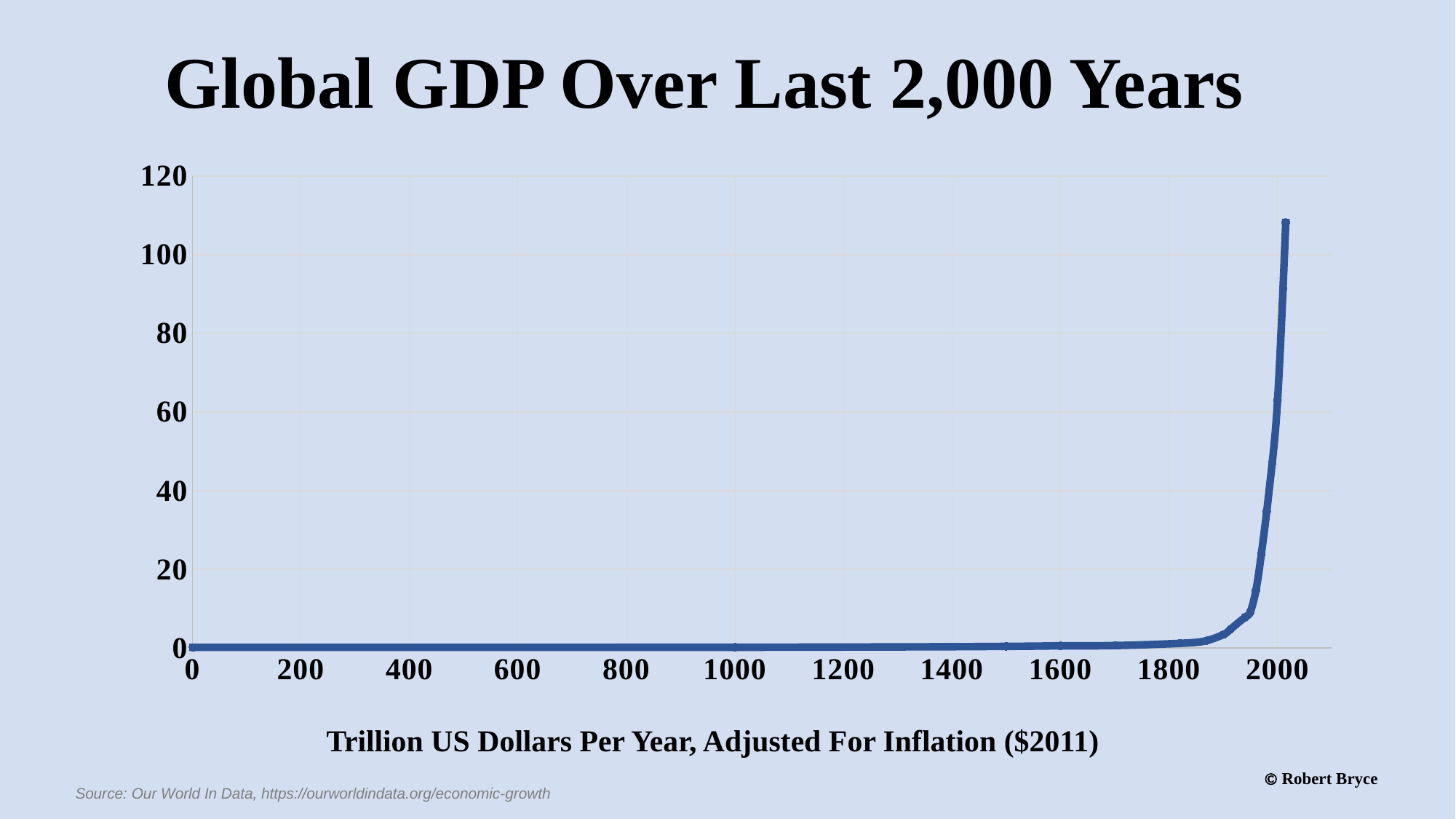
Is the value of global GDP at year 1000 greater or less than 20? less What unit is the y axis measured in, according to the label below the chart? Trillion US Dollars Per Year, Adjusted For Inflation ($2011) Is the value of global GDP at year 1800 greater or less than 20? less Is the highest value reached by the line greater or less than 120? less What is the maximum value shown on the y axis? 120 Around which end of the x axis does the line reach its highest value? 2000 Does global GDP rise or fall along the x axis from year 0 to year 2000? rise What kind of chart is shown on the slide? line chart What is the title of the chart? Global GDP Over Last 2,000 Years Which is larger, global GDP at year 1600 or global GDP at year 2000? year 2000